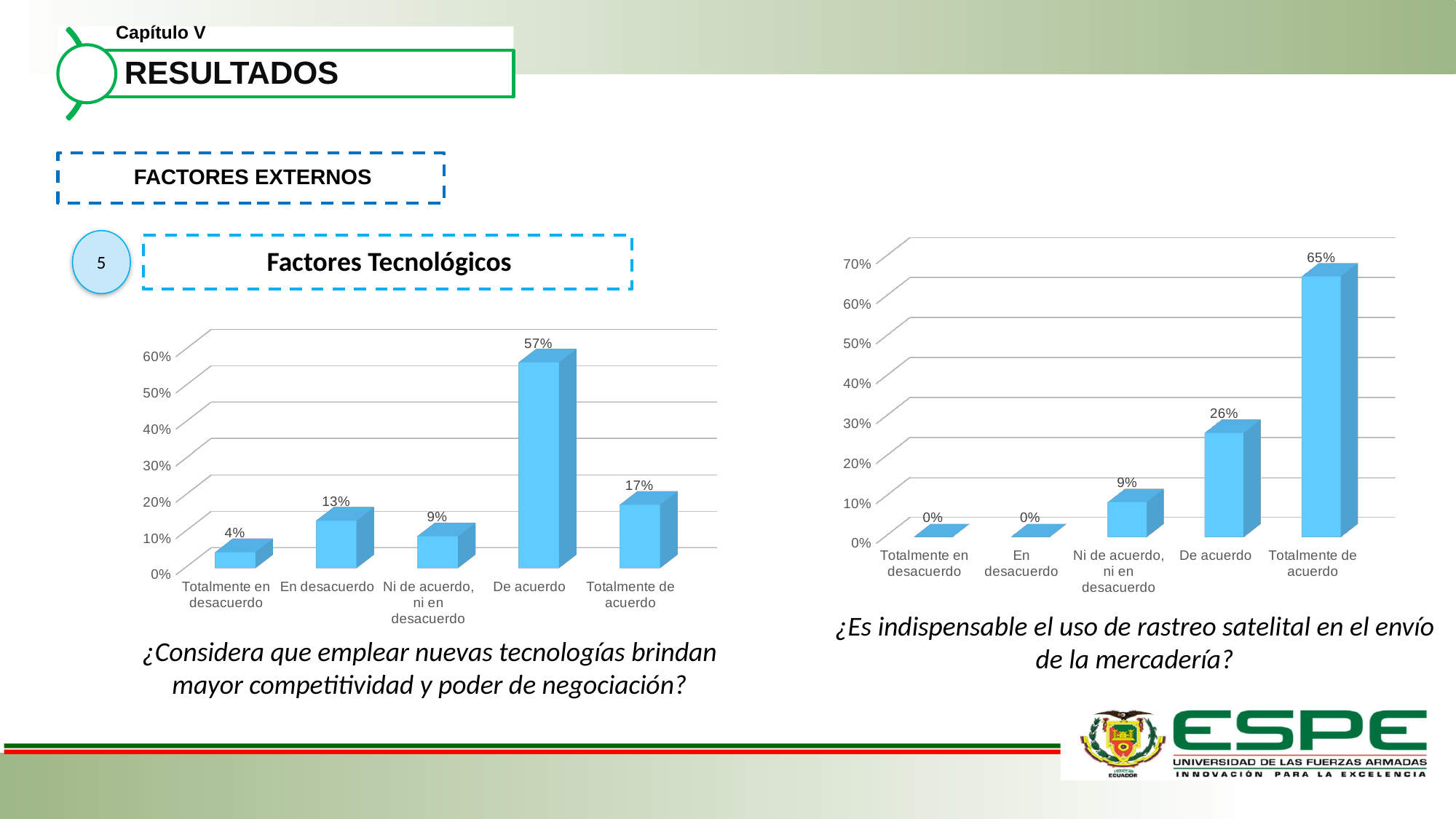
In the left chart (¿Considera que emplear nuevas tecnologías...?), which category has the highest value? De acuerdo In the left chart (¿Considera que emplear nuevas tecnologías...?), which category has the lowest value? Totalmente en desacuerdo In the left chart (¿Considera que emplear nuevas tecnologías...?), how many categories are shown on the x axis? 5 In the left chart (¿Considera que emplear nuevas tecnologías brindan mayor competitividad y poder de negociación?), what is the value for 'De acuerdo'? 57% What type of chart is the right chart (¿Es indispensable el uso de rastreo satelital...?)? Bar chart In the right chart (¿Es indispensable el uso de rastreo satelital...?), what is the difference between 'Totalmente de acuerdo' and 'De acuerdo'? 39% In the left chart (¿Considera que emplear nuevas tecnologías...?), what is the value for 'Totalmente en desacuerdo'? 4% In the left chart (¿Considera que emplear nuevas tecnologías...?), what is the difference between 'De acuerdo' and 'Totalmente de acuerdo'? 40% In the right chart (¿Es indispensable el uso de rastreo satelital en el envío de la mercadería?), what is the value for 'Totalmente de acuerdo'? 65% In the right chart (¿Es indispensable el uso de rastreo satelital...?), which category has the highest value? Totalmente de acuerdo In the right chart (¿Es indispensable el uso de rastreo satelital...?), what is the value for 'De acuerdo'? 26% In the right chart (¿Es indispensable el uso de rastreo satelital...?), which is larger: 'Ni de acuerdo, ni en desacuerdo' or 'De acuerdo'? De acuerdo